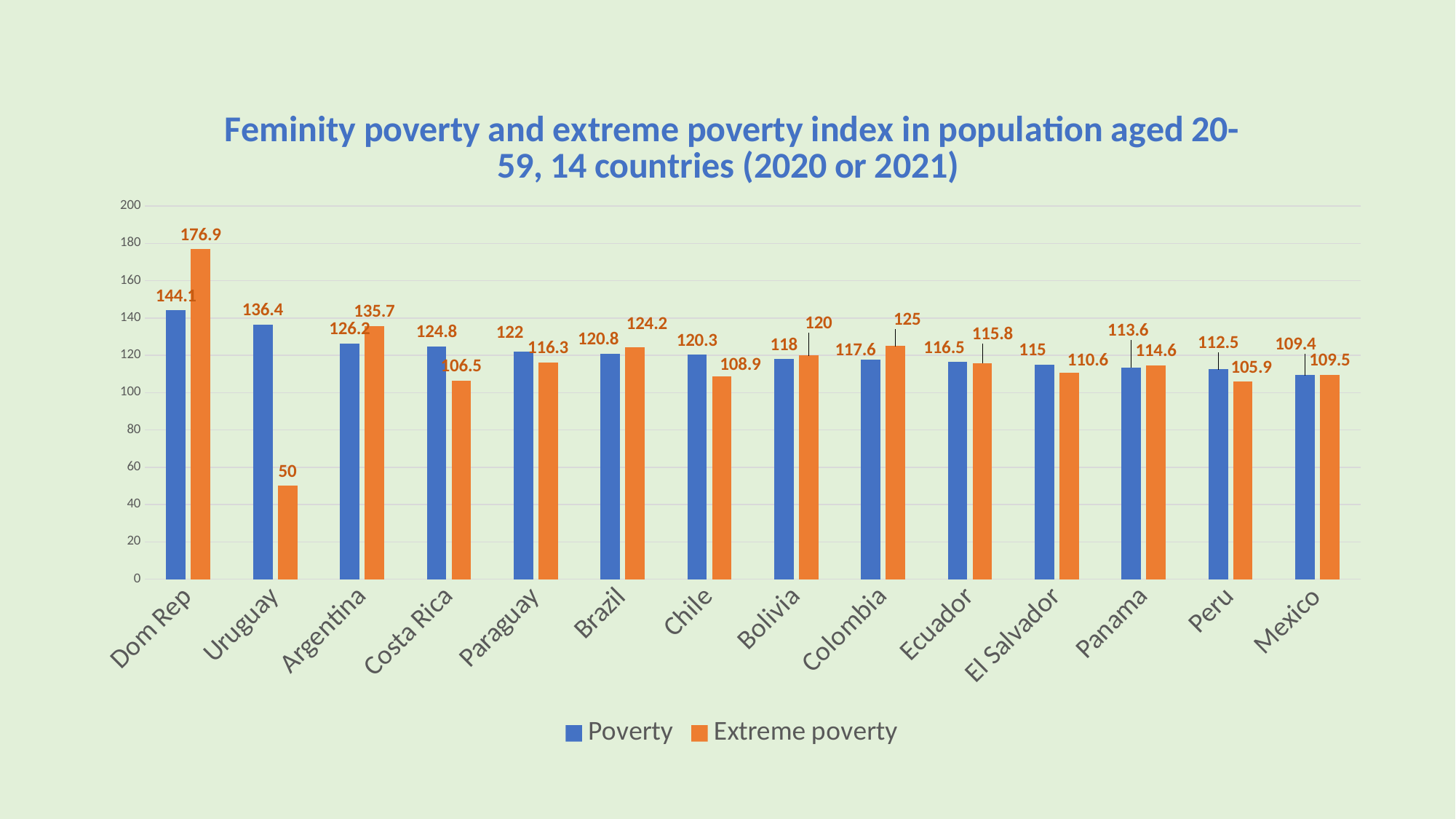
How many series does the legend list? 2 Which country has the lowest Poverty value? Mexico How many countries are shown on the x axis? 14 Which is larger for Chile, the Poverty value or the Extreme poverty value? Poverty What kind of chart is shown on the slide? Bar chart Which country has the lowest Extreme poverty value? Uruguay Which country has the highest Extreme poverty value? Dom Rep What is the difference between the Extreme poverty and Poverty values for Dom Rep? 32.8 What is the Poverty value for Dom Rep? 144.1 What is the Extreme poverty value for Colombia? 125 Which colour represents the Extreme poverty series? Orange What is the Extreme poverty value for Uruguay? 50